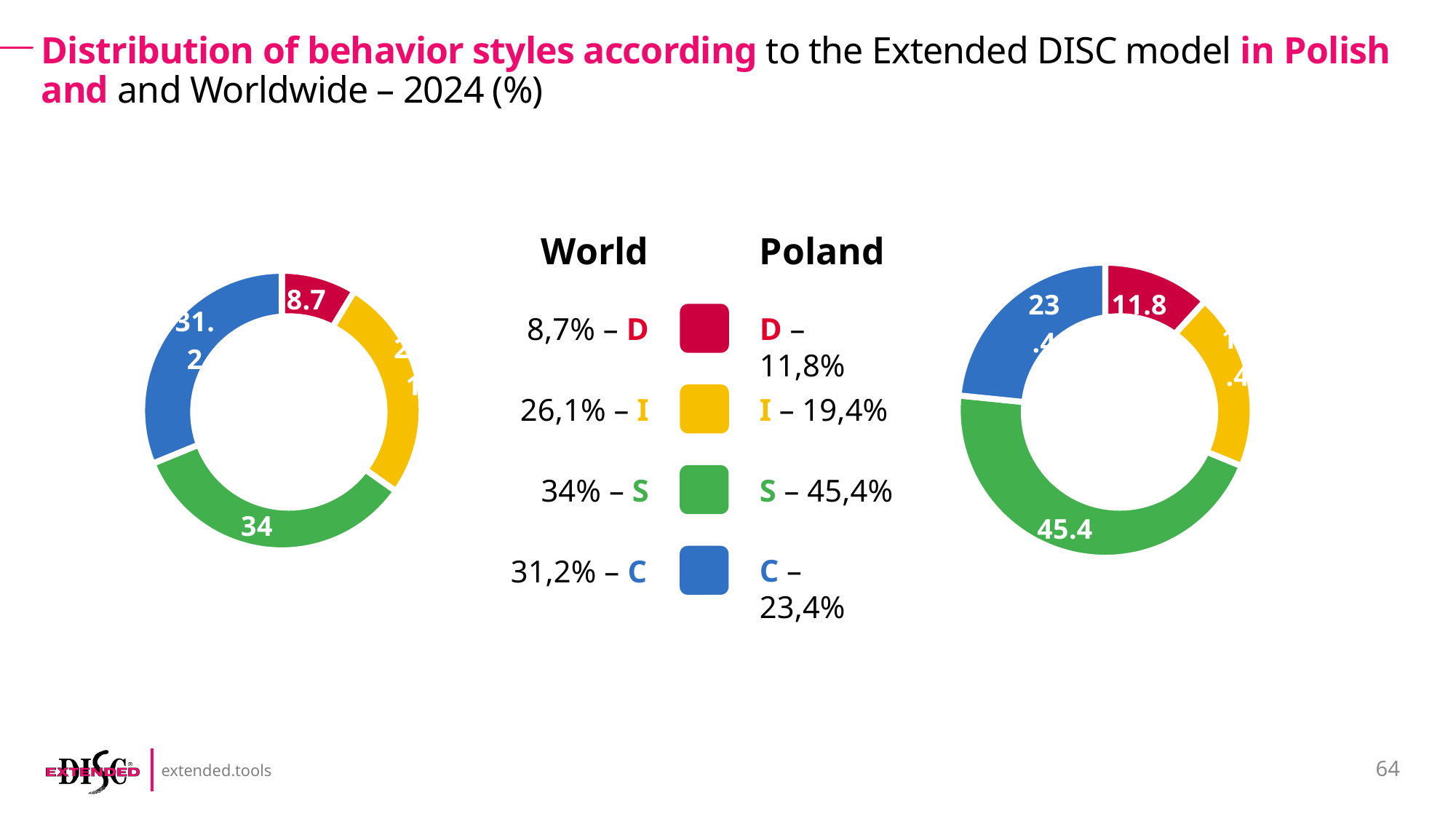
What is the difference between the D value on the Poland chart and the D value on the World chart? 3,1% On the Poland chart, what is the value for I? 19,4% On the Poland chart, what is the value for S? 45,4% What is the difference between the S value on the Poland chart and the S value on the World chart? 11,4% What colour represents the S style in the legend? Green What kind of chart is used on the left of the slide? Donut (pie) chart On the World chart, what is the value for D? 8,7% On the Poland chart, which style has the smallest share? D Which is larger: the C value on the World chart or the C value on the Poland chart? World On the World chart, what is the value for C? 31,2% How many slices does the Poland chart have? 4 On the World chart, which style has the largest share? S